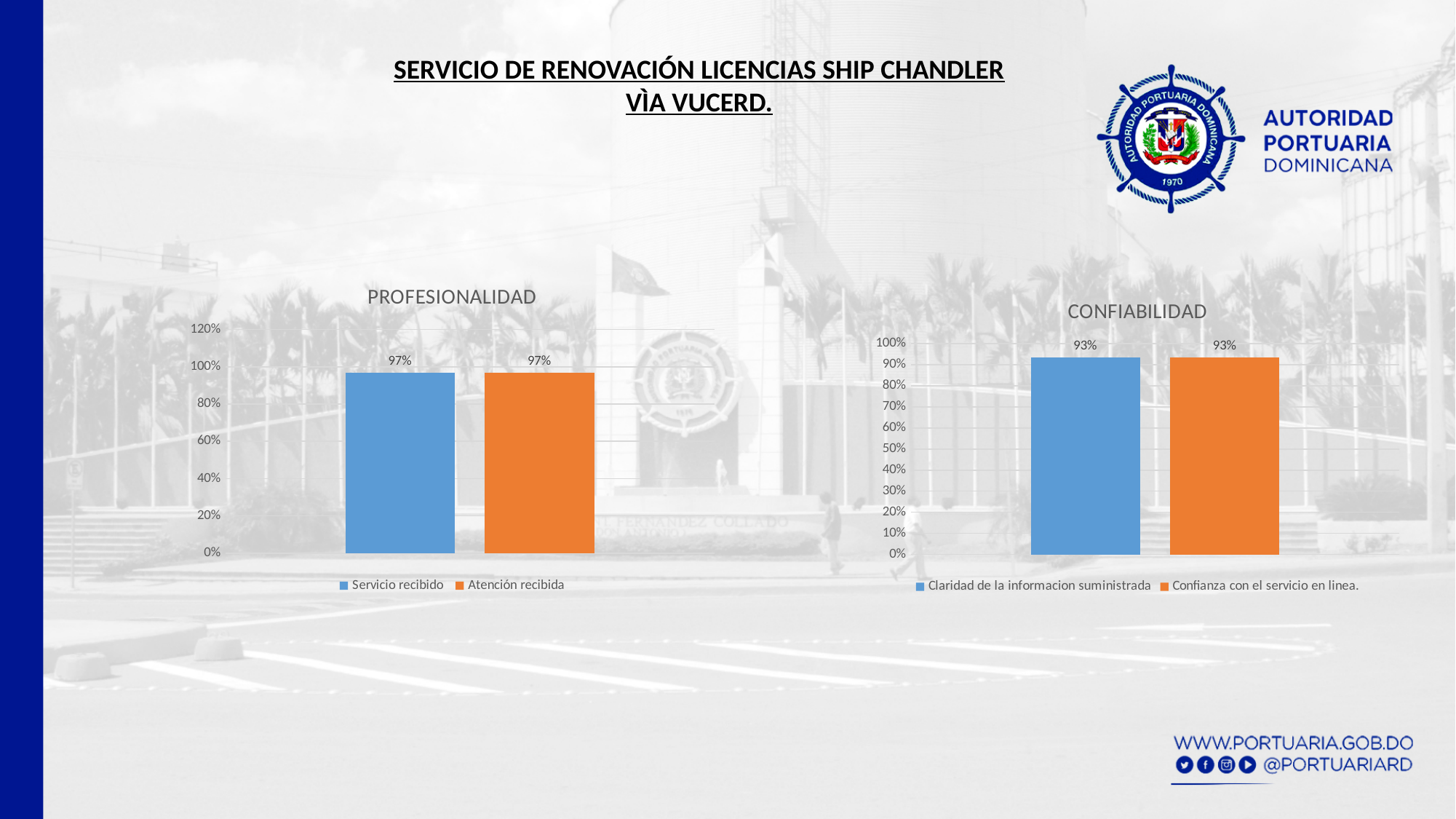
In the CONFIABILIDAD chart, what is the value for Claridad de la informacion suministrada? 93% In the PROFESIONALIDAD chart, what is the highest value shown on the vertical axis? 120% In the CONFIABILIDAD chart, what is the difference between the two series values? 0% In the PROFESIONALIDAD chart, how many series does the legend list? 2 In the CONFIABILIDAD chart, what colour is the bar for Confianza con el servicio en linea.? Orange In the CONFIABILIDAD chart, what is the value for Confianza con el servicio en linea.? 93% In the PROFESIONALIDAD chart, what is the difference between Servicio recibido and Atención recibida? 0% In the PROFESIONALIDAD chart, what is the value for Atención recibida? 97% In the PROFESIONALIDAD chart, what is the value for Servicio recibido? 97% What kind of chart is the PROFESIONALIDAD chart? Bar chart In the CONFIABILIDAD chart, how many series does the legend list? 2 In the CONFIABILIDAD chart, is the value for Claridad de la informacion suministrada greater or less than 80%? greater